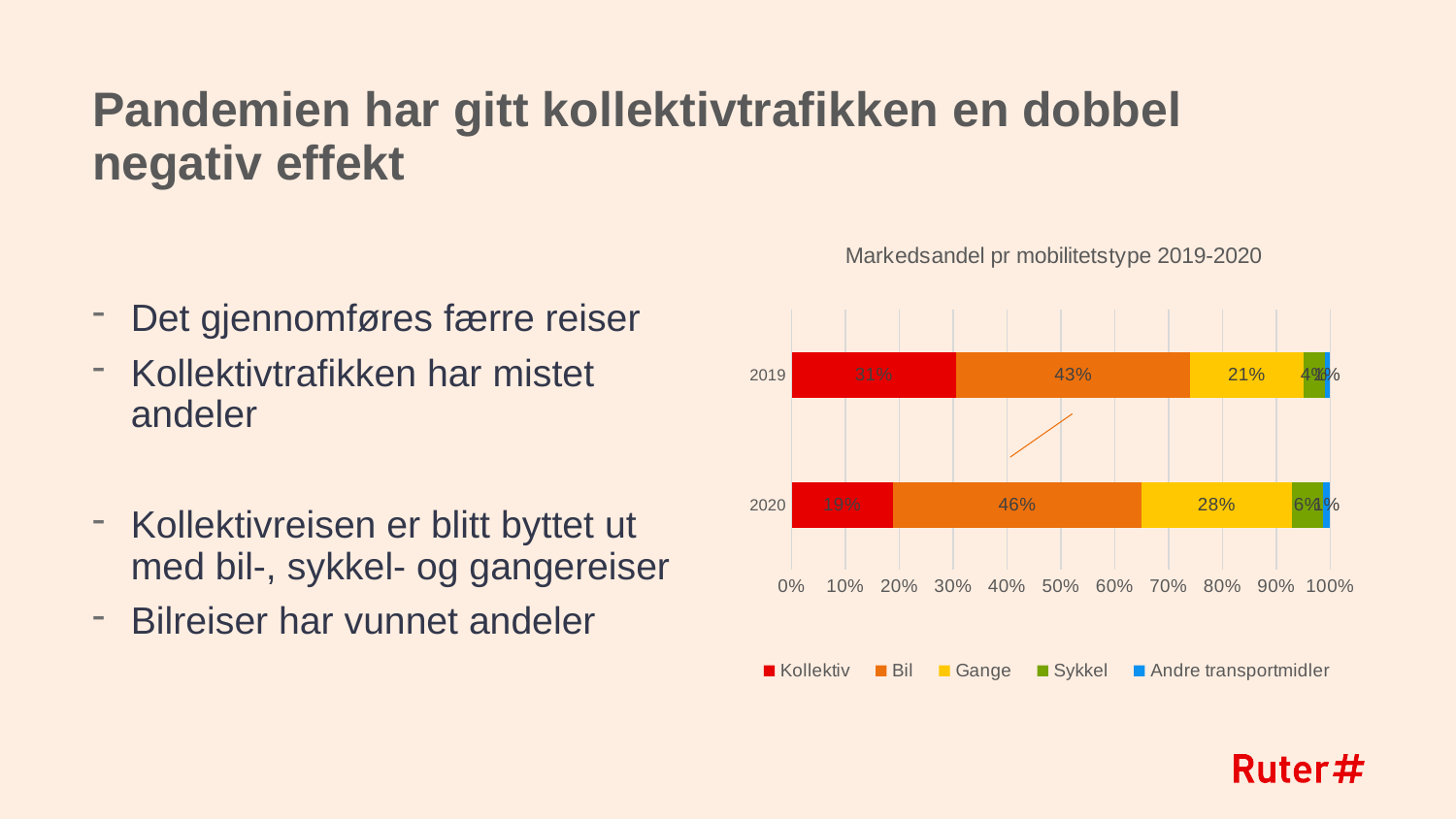
Which year has the larger share for Kollektiv, 2019 or 2020? 2019 What is the market share for Bil in 2019? 43% What is the market share for Gange in 2019? 21% By how many percentage points did the share for Gange change from 2019 to 2020? 7 percentage points How many years (categories) are plotted in the chart? 2 Which mobility type has the largest share in 2020? Bil What is the title of the chart? Markedsandel pr mobilitetstype 2019-2020 What is the market share for Bil in 2020? 46% What is the market share for Gange in 2020? 28% How many series does the chart legend list? 5 What is the market share for Kollektiv in 2020? 19% What kind of chart is shown on the slide? Stacked bar chart